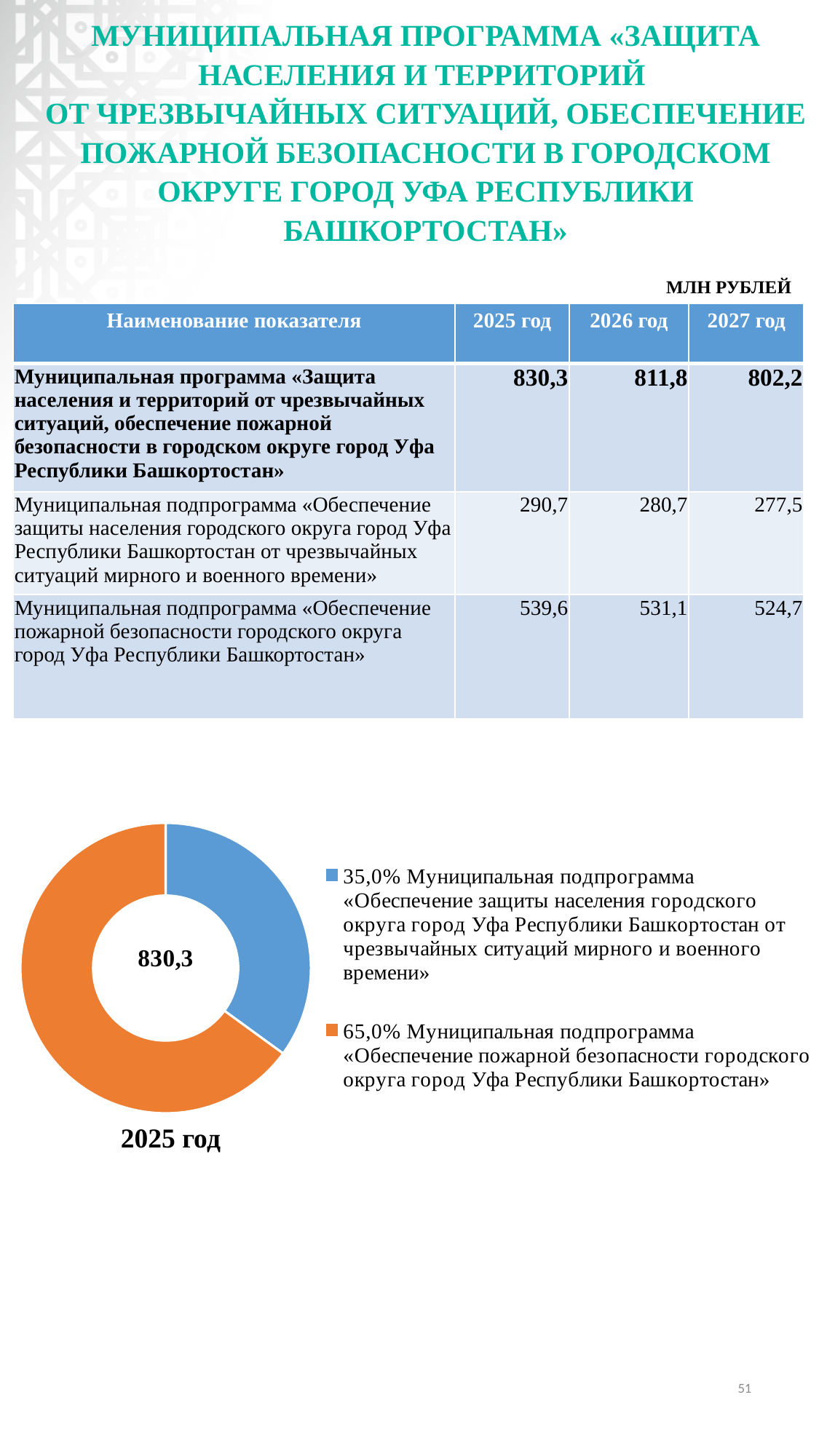
What is the difference in percentage points between the two slices of the doughnut chart? 30,0% Which slice of the doughnut chart is the smallest? Муниципальная подпрограмма «Обеспечение защиты населения городского округа город Уфа Республики Башкортостан от чрезвычайных ситуаций мирного и военного времени» (35,0%) Which year does the doughnut chart represent, according to the label below it? 2025 год What share of the doughnut chart does the subprogram «Обеспечение пожарной безопасности городского округа город Уфа Республики Башкортостан» take? 65,0% How many slices does the doughnut chart have? 2 What kind of chart is shown on the slide? Doughnut (pie) chart What value is printed in the centre of the doughnut chart? 830,3 What share of the doughnut chart does the subprogram «Обеспечение защиты населения городского округа город Уфа Республики Башкортостан от чрезвычайных ситуаций мирного и военного времени» take? 35,0% How many entries does the legend of the doughnut chart list? 2 Which slice of the doughnut chart is the largest? Муниципальная подпрограмма «Обеспечение пожарной безопасности городского округа город Уфа Республики Башкортостан» (65,0%) In the doughnut chart, which is larger: the share for fire safety (пожарной безопасности) or the share for protection from emergencies (защиты населения от чрезвычайных ситуаций)? Fire safety (65,0%)